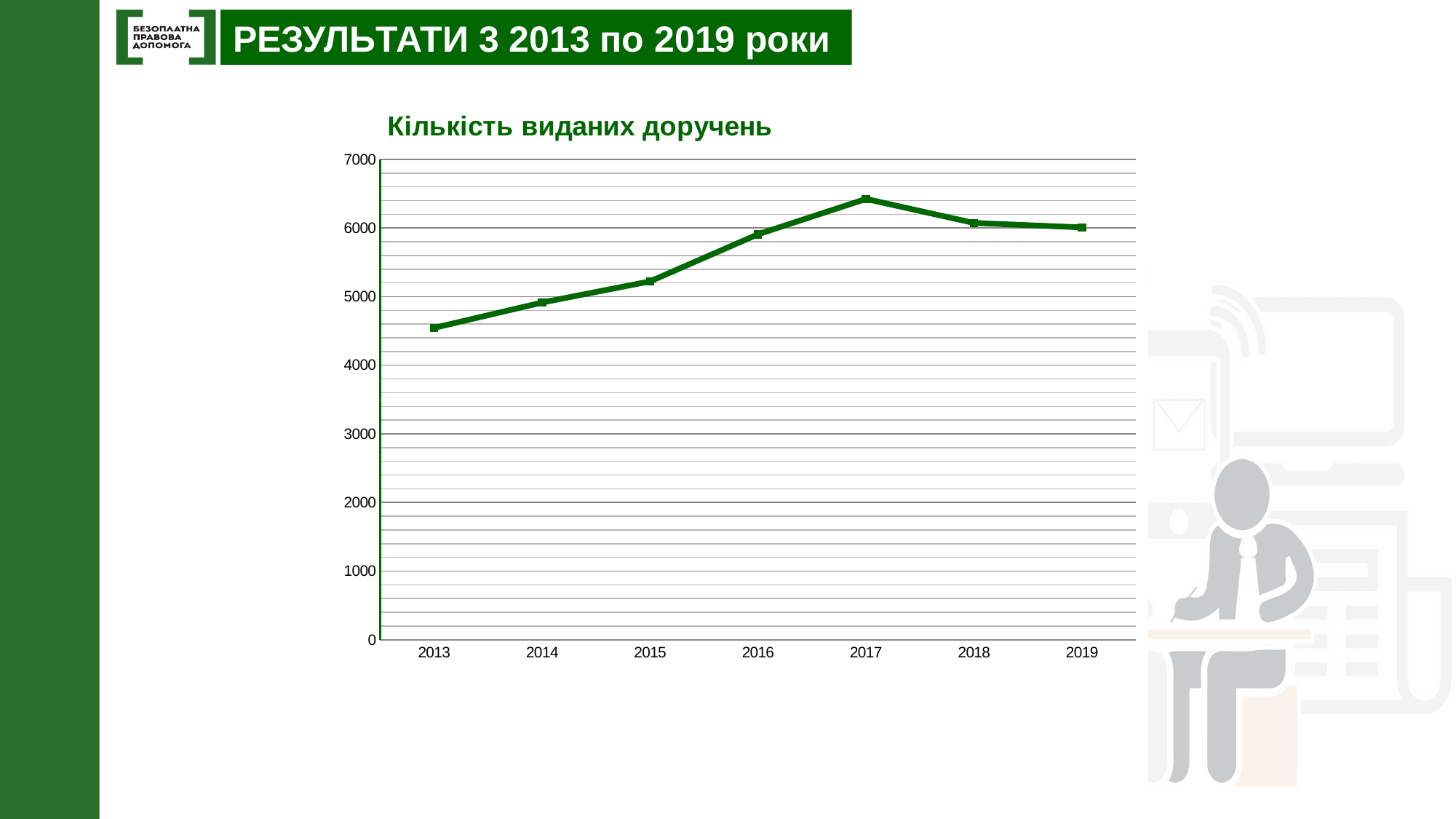
Is the value for 2017 greater or less than 6000? greater How many years (data points) are plotted on the x axis? 7 Is the value for 2013 greater or less than 4000? greater What is the title of the chart? Кількість виданих доручень How do the values change from 2013 to 2017? they rise Is the value for 2013 greater or less than 5000? less What kind of chart is shown on the slide? line chart Which is larger, the value for 2017 or the value for 2013? 2017 Which year has the lowest value? 2013 Which year has the highest value? 2017